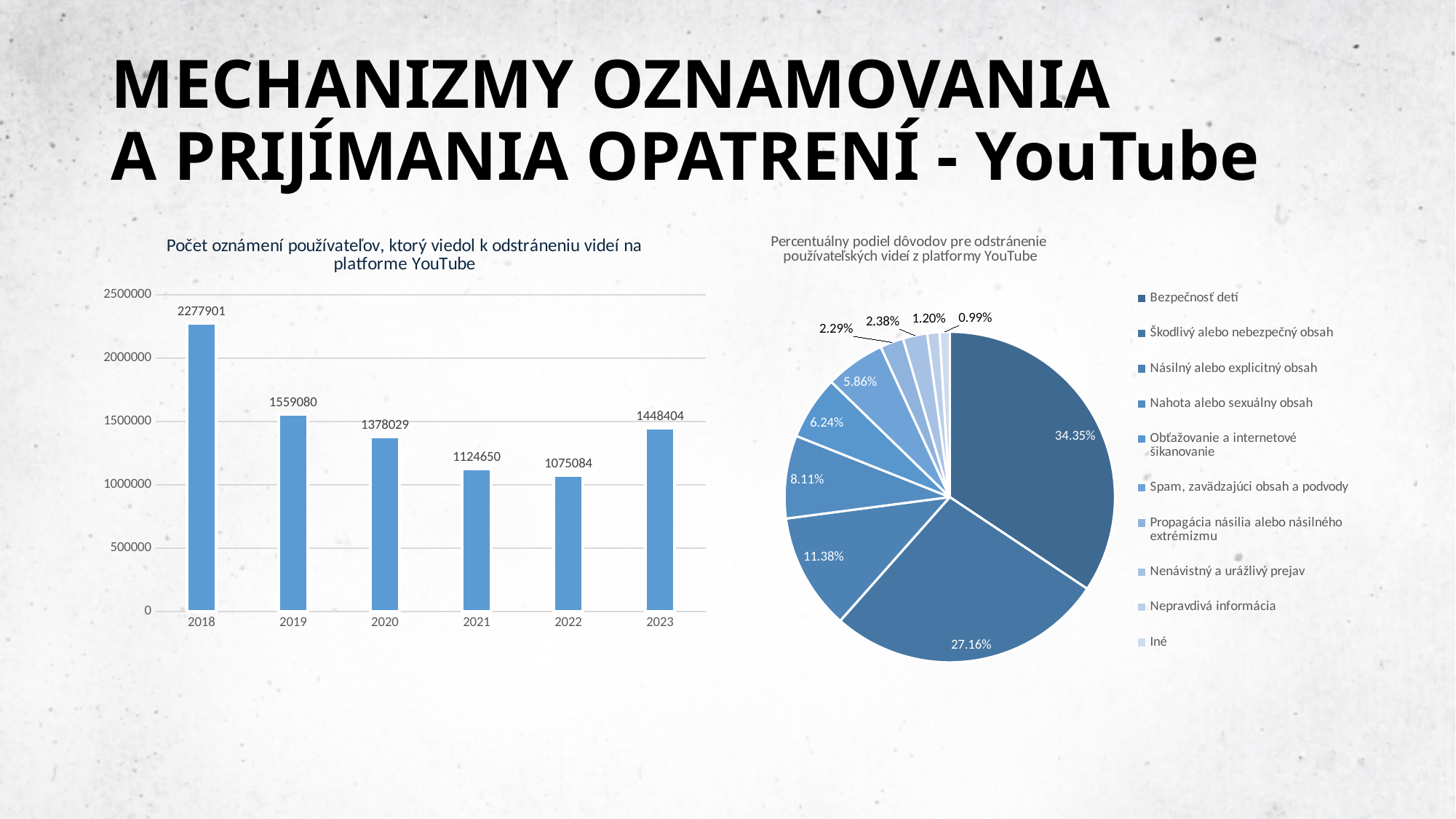
In the left chart (Počet oznámení používateľov...), which is larger, the value for 2021 or the value for 2023? 2023 In the left chart (Počet oznámení používateľov...), what is the value for 2022? 1075084 In the left chart (Počet oznámení používateľov...), what is the value for 2018? 2277901 In the left chart (Počet oznámení používateľov...), how many years are shown on the x axis? 6 In the left chart (Počet oznámení používateľov...), which year has the lowest value? 2022 What kind of chart is the left chart (Počet oznámení používateľov...)? Bar chart How many categories does the legend of the right chart (Percentuálny podiel dôvodov...) list? 10 In the right chart (Percentuálny podiel dôvodov...), what share does Škodlivý alebo nebezpečný obsah have? 27.16% In the left chart (Počet oznámení používateľov...), what is the difference between the values for 2019 and 2020? 181051 In the left chart (Počet oznámení používateľov...), do the values rise or fall from 2018 to 2022? Fall In the left chart (Počet oznámení používateľov...), which year has the highest value? 2018 In the right chart (Percentuálny podiel dôvodov...), what share does Bezpečnosť detí have? 34.35%